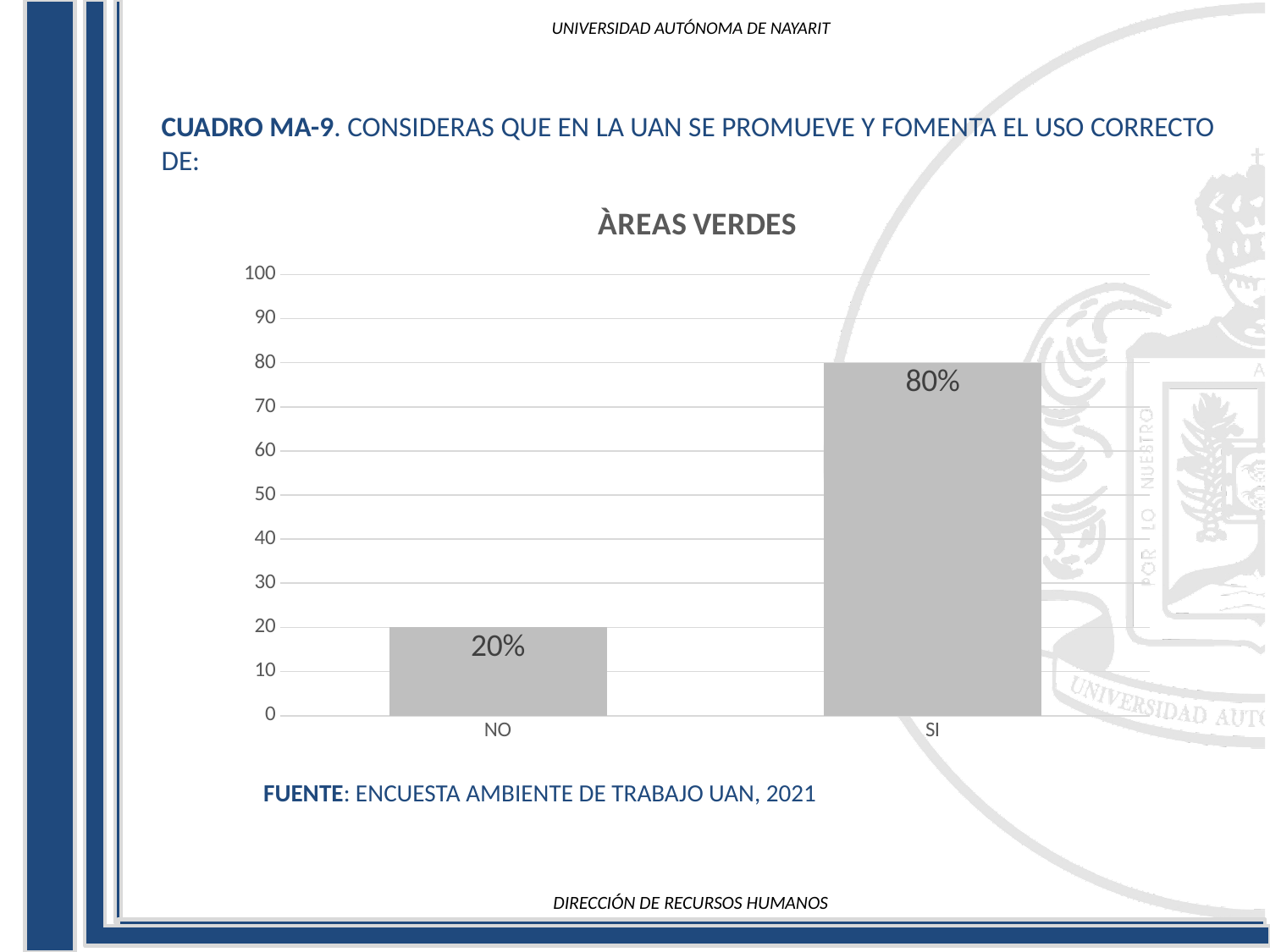
What is the value for NO? 20% What kind of chart is shown? bar chart What is the value for SI? 80% Is the value for SI greater or less than 50? greater Which category has the lowest value? NO Which category has the highest value? SI Is the value for NO greater or less than 30? less How many categories are shown on the x axis? 2 Which is larger, the value for NO or the value for SI? SI What is the title of the chart? ÀREAS VERDES What is the maximum value shown on the y axis? 100 What is the difference between the values for SI and NO? 60%